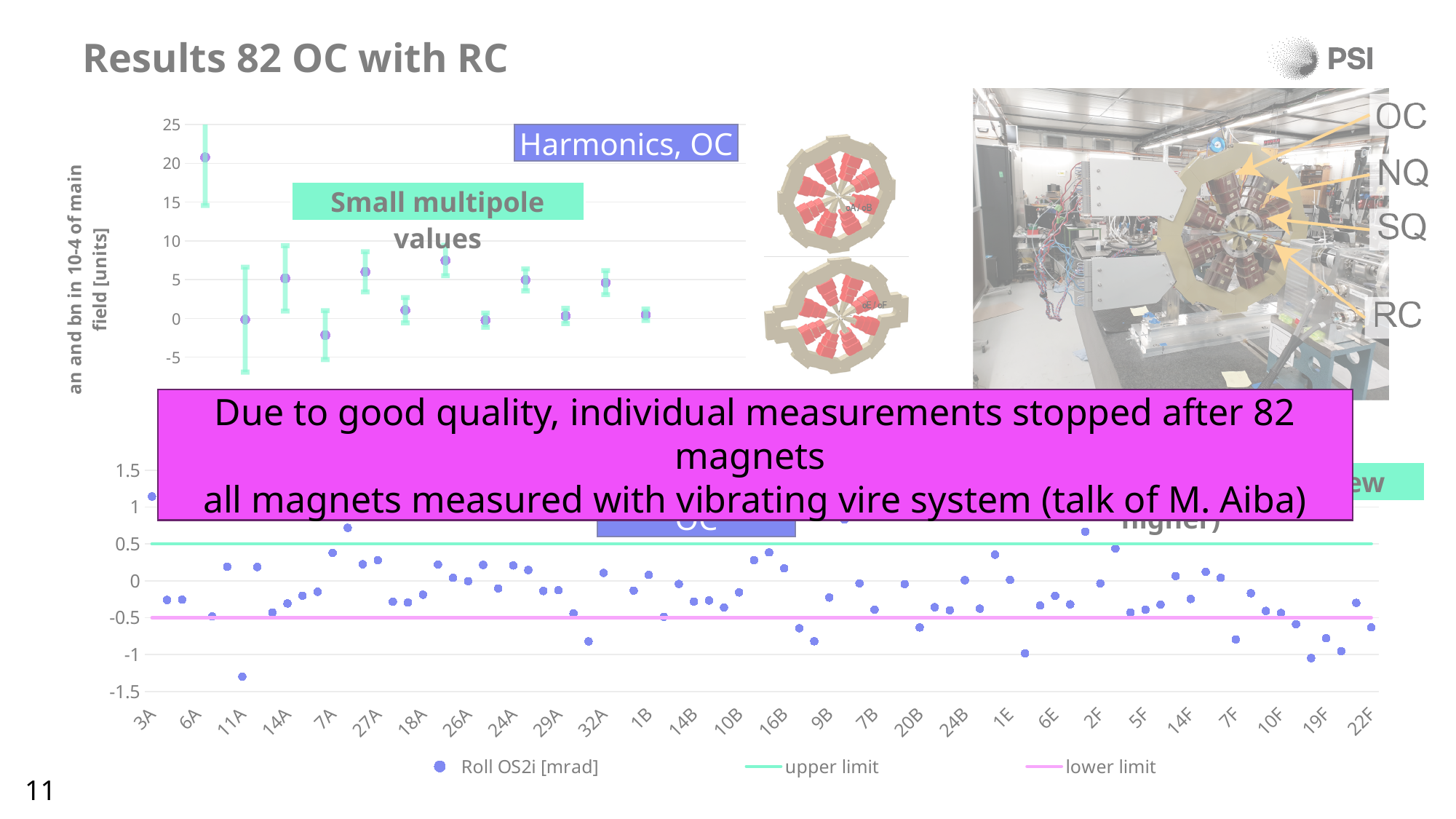
On the top chart (Harmonics, OC), is the value of the first (leftmost) point greater or less than 15? greater On the bottom chart, how many series does the legend list? 3 On the bottom chart, is the Roll OS2i value at 3A greater or less than 1? greater What kind of chart is the bottom chart showing Roll OS2i? scatter chart On the bottom chart, what are the three legend entries? Roll OS2i [mrad], upper limit, lower limit On the bottom chart, what is the lowest tick value shown on the y axis? -1.5 On the bottom chart, at what value is the upper limit line drawn? 0.5 On the top chart (Harmonics, OC), what is the highest tick value shown on the y axis? 25 On the bottom chart, at what value is the lower limit line drawn? -0.5 On the bottom chart, is the Roll OS2i value at 11A greater or less than -1? less